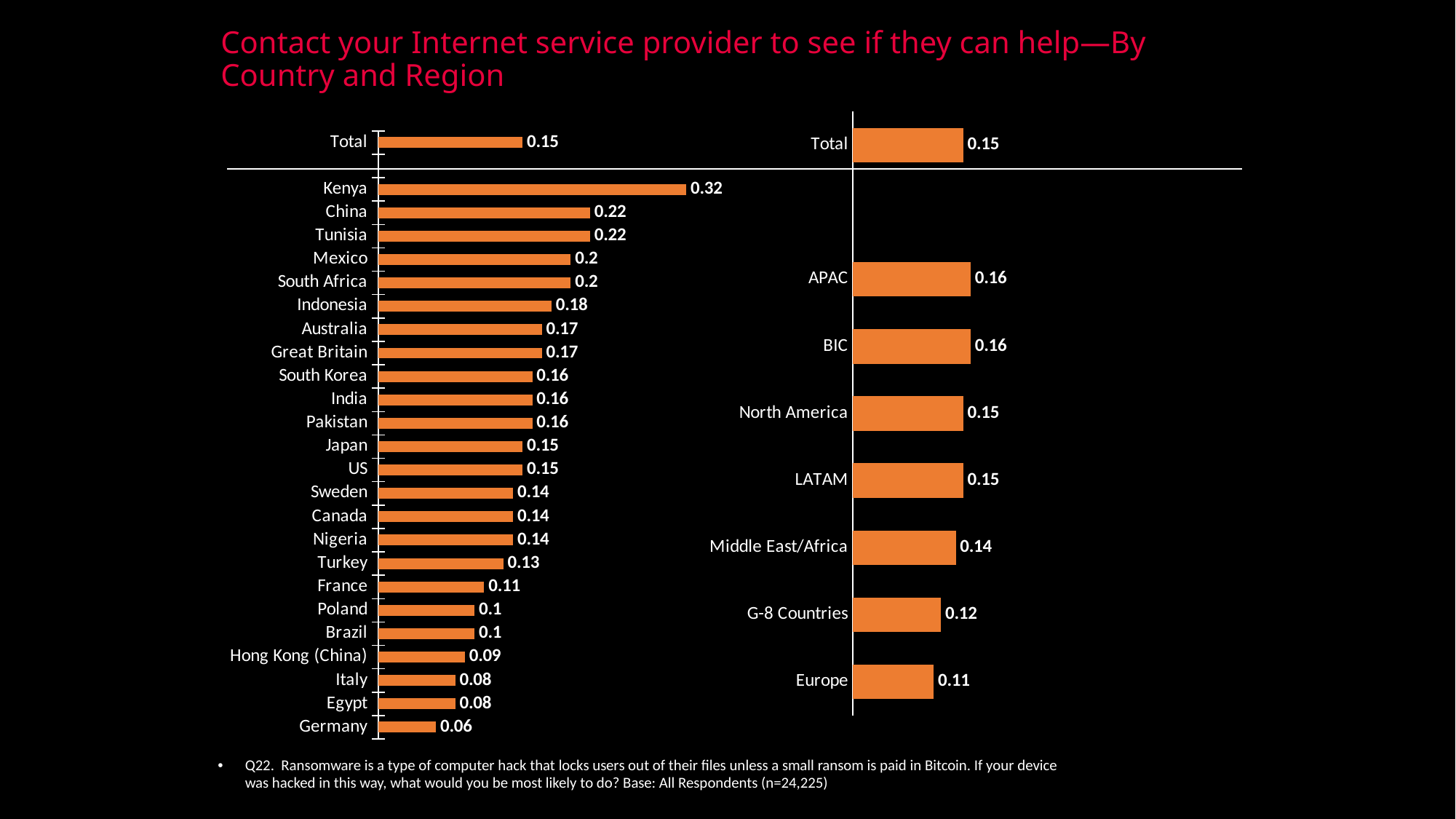
In the right chart (by region), what is the value for Middle East/Africa? 0.14 In the left chart (by country), what is the value for Germany? 0.06 In the left chart (by country), what is the value for Kenya? 0.32 In the right chart (by region), which region has the lowest value? Europe How many countries (excluding Total) are shown in the left chart? 24 In the left chart (by country), which country has the highest value? Kenya In the right chart (by region), what is the value for G-8 Countries? 0.12 What type of chart is used on this slide? Bar chart In the left chart (by country), which has a larger value, Mexico or France? Mexico In the left chart (by country), which country has the lowest value? Germany In the left chart (by country), what is the difference between the values for Kenya and China? 0.1 In the right chart (by region), what is the difference between the values for APAC and Europe? 0.05